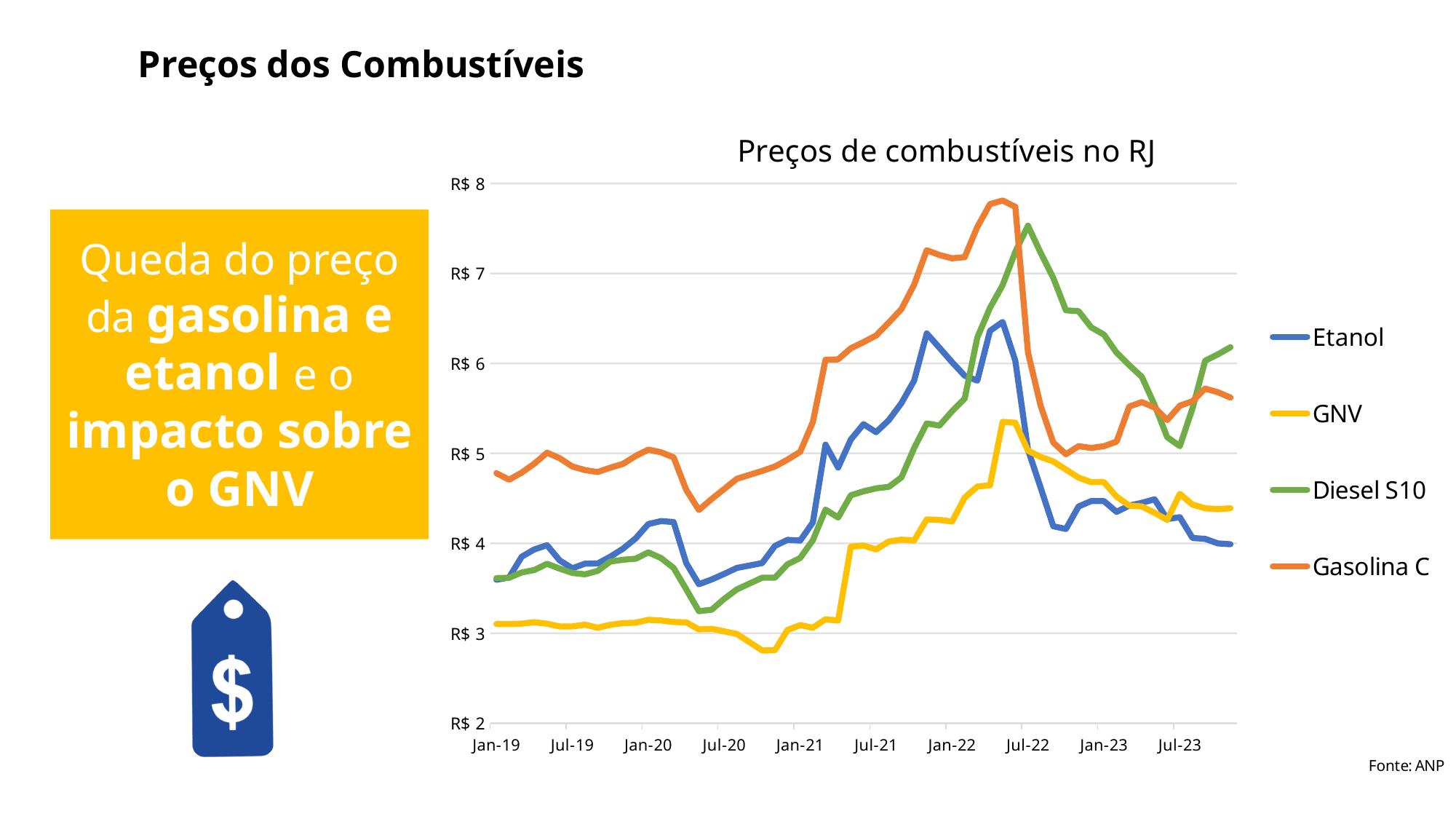
Does the Etanol line rise or fall between Jan-22 and Jul-23? Fall Is the peak value of Diesel S10 greater or less than R$ 7? greater Which series is drawn in orange in the chart? Gasolina C Is the value for Gasolina C at Jan-19 greater or less than R$ 4? greater What is the title of the chart? Preços de combustíveis no RJ At Jul-23, which is higher: Diesel S10 or GNV? Diesel S10 Which series reaches the highest value anywhere on the chart? Gasolina C What kind of chart is shown on the slide? Line chart How many tick labels are shown on the x axis? 10 How many series does the chart legend list? 4 Is the value for GNV at Jan-21 greater or less than R$ 4? less Which series has the lowest value at Jan-19? GNV